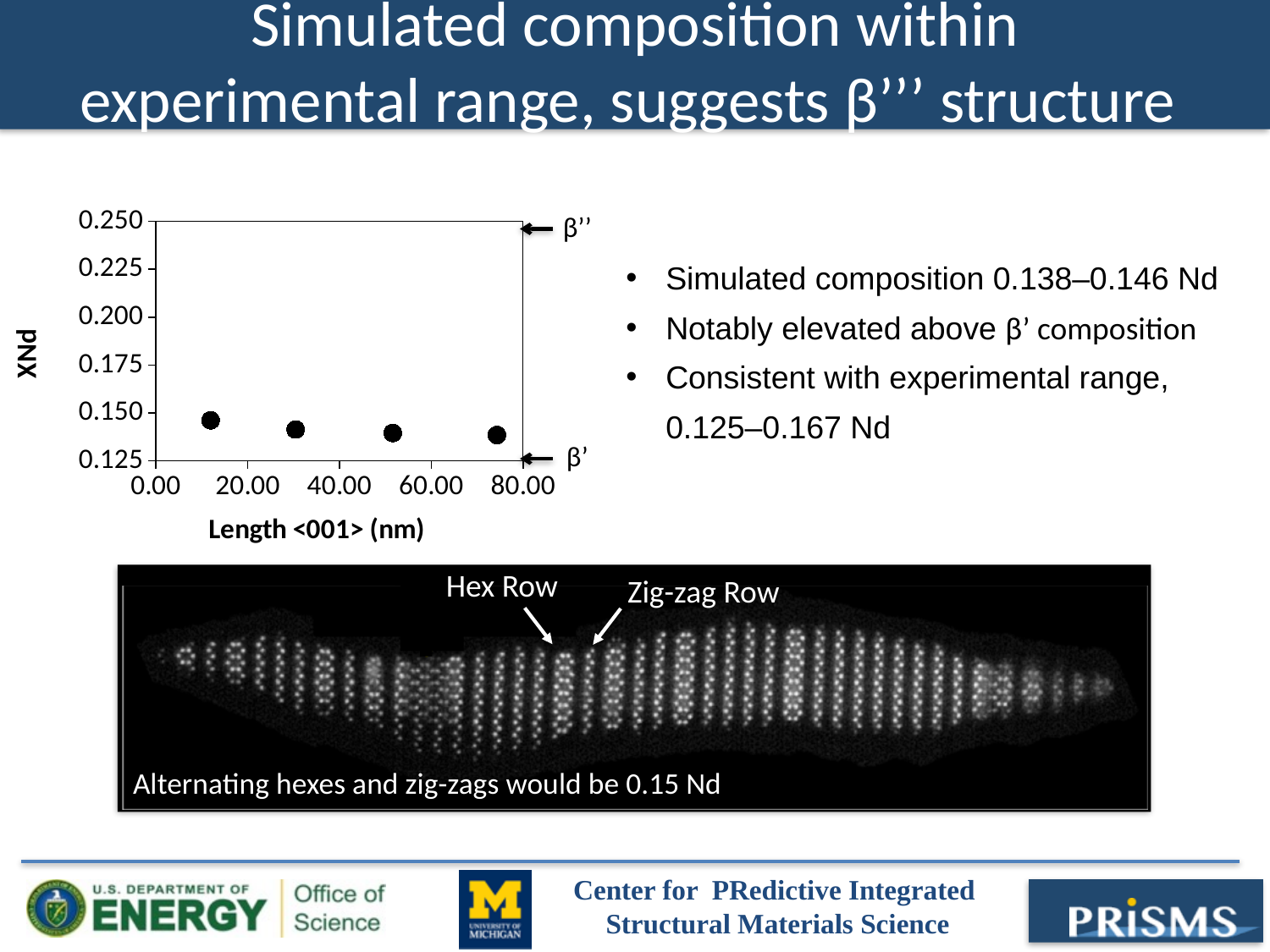
Is the XNd value of the rightmost data point greater or less than 0.125? greater Are all of the plotted points below 0.175 on the XNd axis? yes What kind of chart is shown on the slide? scatter plot How many data points are plotted in the chart? 4 What is the label of the x axis of the chart? Length <001> (nm) Which phase label is marked with an arrow at the top of the y axis (0.250)? β'' Is the XNd value of the rightmost data point greater or less than 0.150? less Do the plotted XNd values rise or fall as Length <001> increases along the x axis? fall Which data point has the higher XNd value, the leftmost or the rightmost? the leftmost